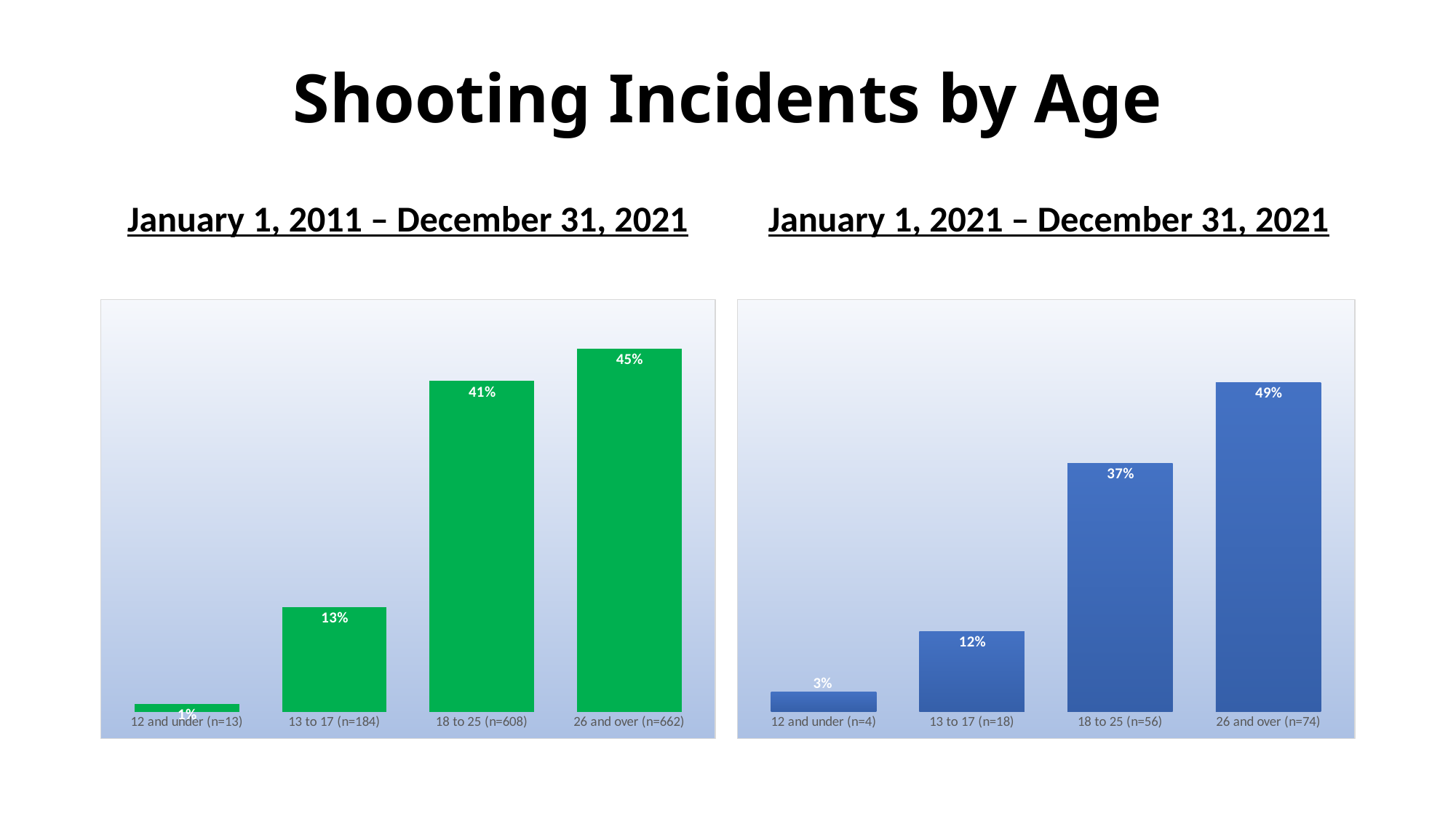
In the January 1, 2021 – December 31, 2021 chart, what is the value for 13 to 17 (n=18)? 12% In the January 1, 2011 – December 31, 2021 chart, what is the value for 18 to 25 (n=608)? 41% In the January 1, 2011 – December 31, 2021 chart, which age group has the highest value? 26 and over (n=662) What kind of chart is the January 1, 2011 – December 31, 2021 chart? Bar chart In the January 1, 2021 – December 31, 2021 chart, which age group has the lowest value? 12 and under (n=4) In the January 1, 2021 – December 31, 2021 chart, what is the value for 12 and under (n=4)? 3% In the January 1, 2021 – December 31, 2021 chart, what is the difference between the values for 26 and over (n=74) and 18 to 25 (n=56)? 12% How many age categories are shown in the January 1, 2021 – December 31, 2021 chart? 4 In the January 1, 2011 – December 31, 2021 chart, what is the difference between the values for 13 to 17 (n=184) and 12 and under (n=13)? 12% In the January 1, 2021 – December 31, 2021 chart, do the values rise or fall from left to right across the age groups? Rise In the January 1, 2011 – December 31, 2021 chart, which is larger: the value for 18 to 25 (n=608) or 26 and over (n=662)? 26 and over (n=662) What colour are the bars in the January 1, 2011 – December 31, 2021 chart? Green